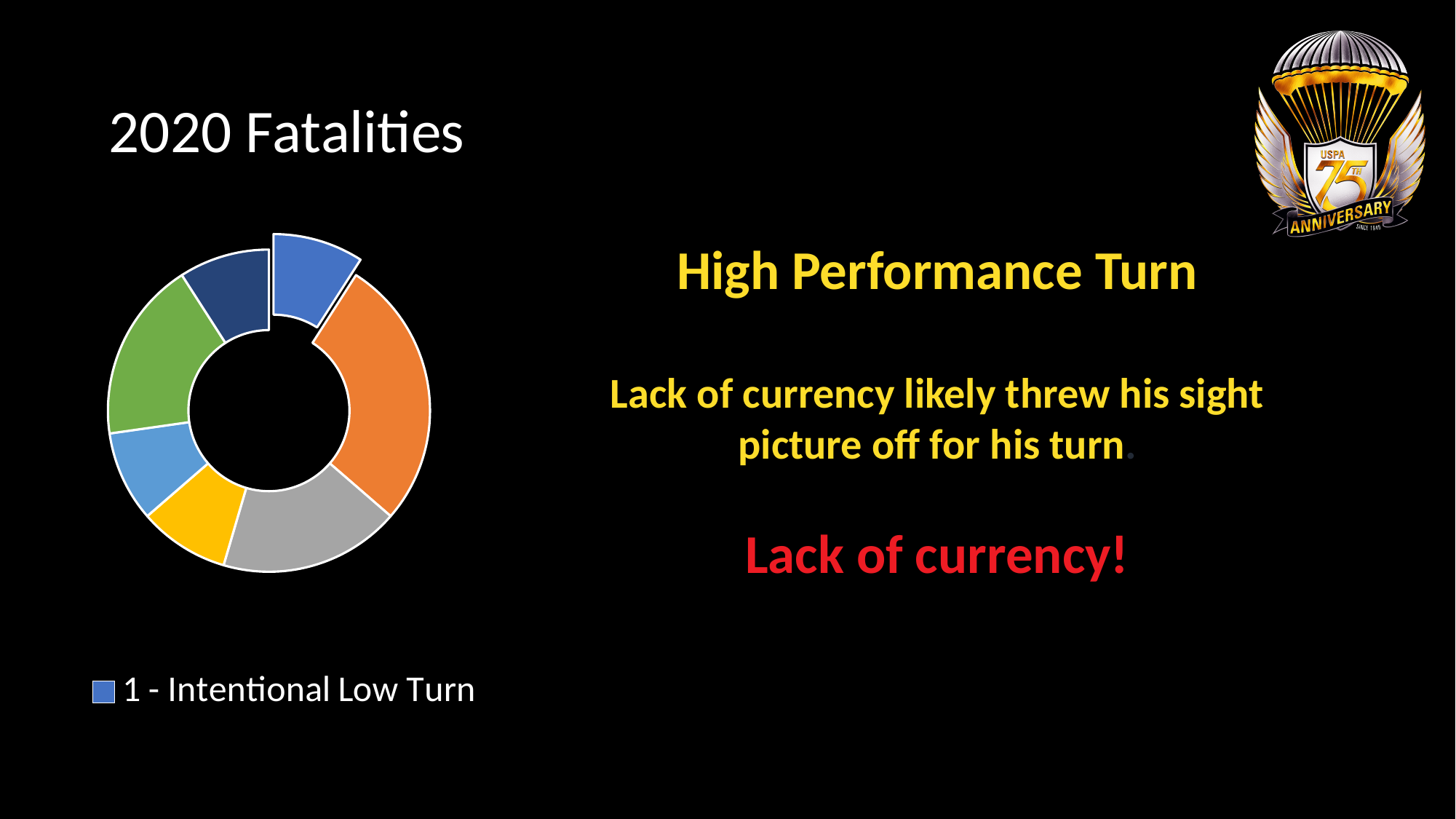
How many fatalities does the legend give for Intentional Low Turn? 1 How many slices does the doughnut chart have? 7 Is the Intentional Low Turn slice larger or smaller than the orange slice? Smaller What kind of chart is shown on the slide? Doughnut (pie) chart How many entries does the chart legend list? 1 What is the title of the chart on the slide? 2020 Fatalities What is the only category named in the chart legend? 1 - Intentional Low Turn Which colour slice of the doughnut chart is the largest? Orange